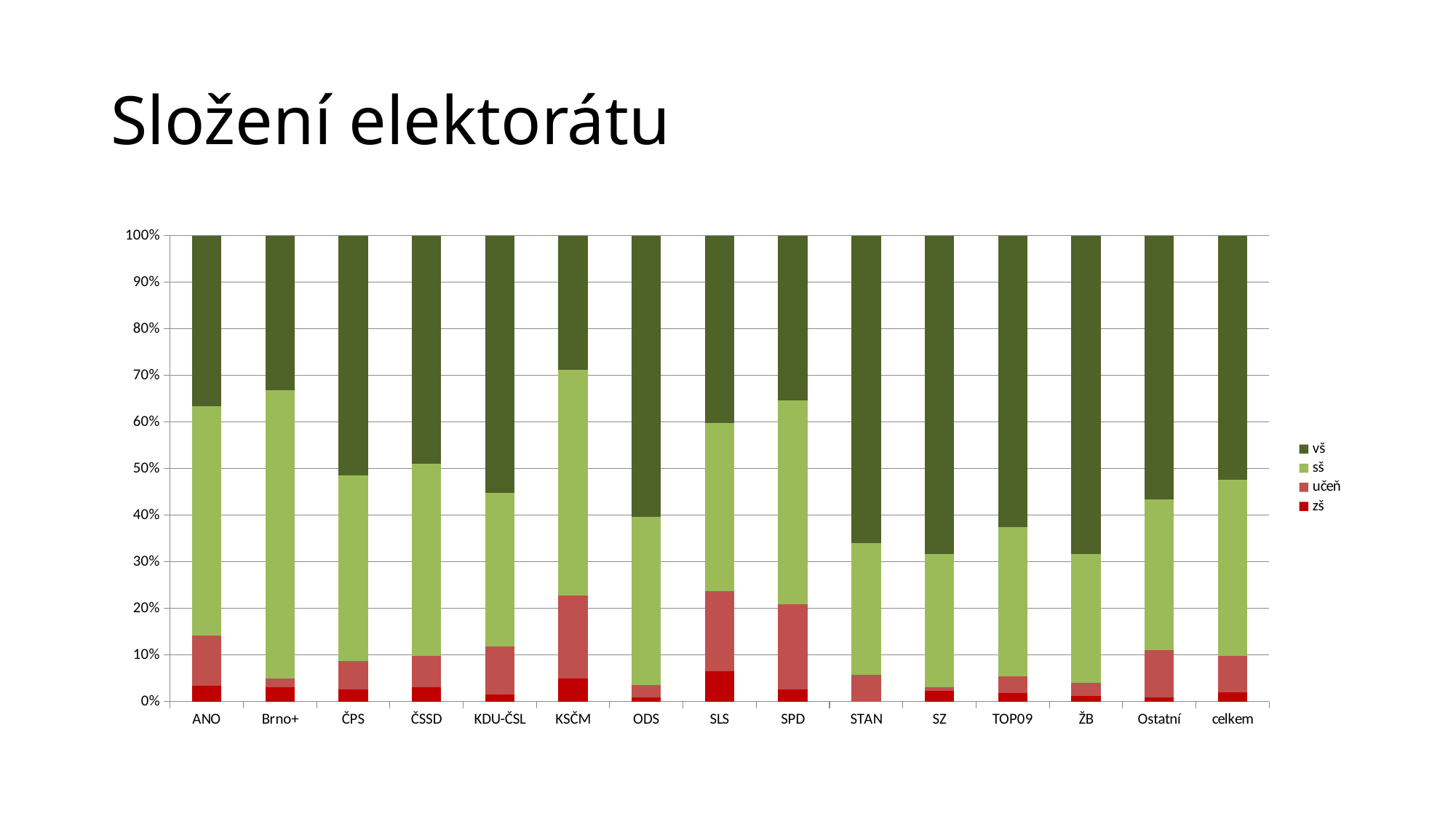
Which category has the smallest vš share? KSČM Which series is shown in the darkest green at the top of each bar? vš Which has the larger vš share, ODS or ANO? ODS Is the vš share for KSČM greater or less than 40%? less What kind of chart is shown on the slide? stacked bar chart How many categories are shown along the x axis of the chart? 15 Is the zš share for SLS greater or less than 10%? less Which category has the largest zš share? SLS Is the vš share for STAN greater or less than 60%? greater Which category has the largest sš share? Brno+ What is the title of the slide containing the chart? Složení elektorátu How many series does the legend list? 4